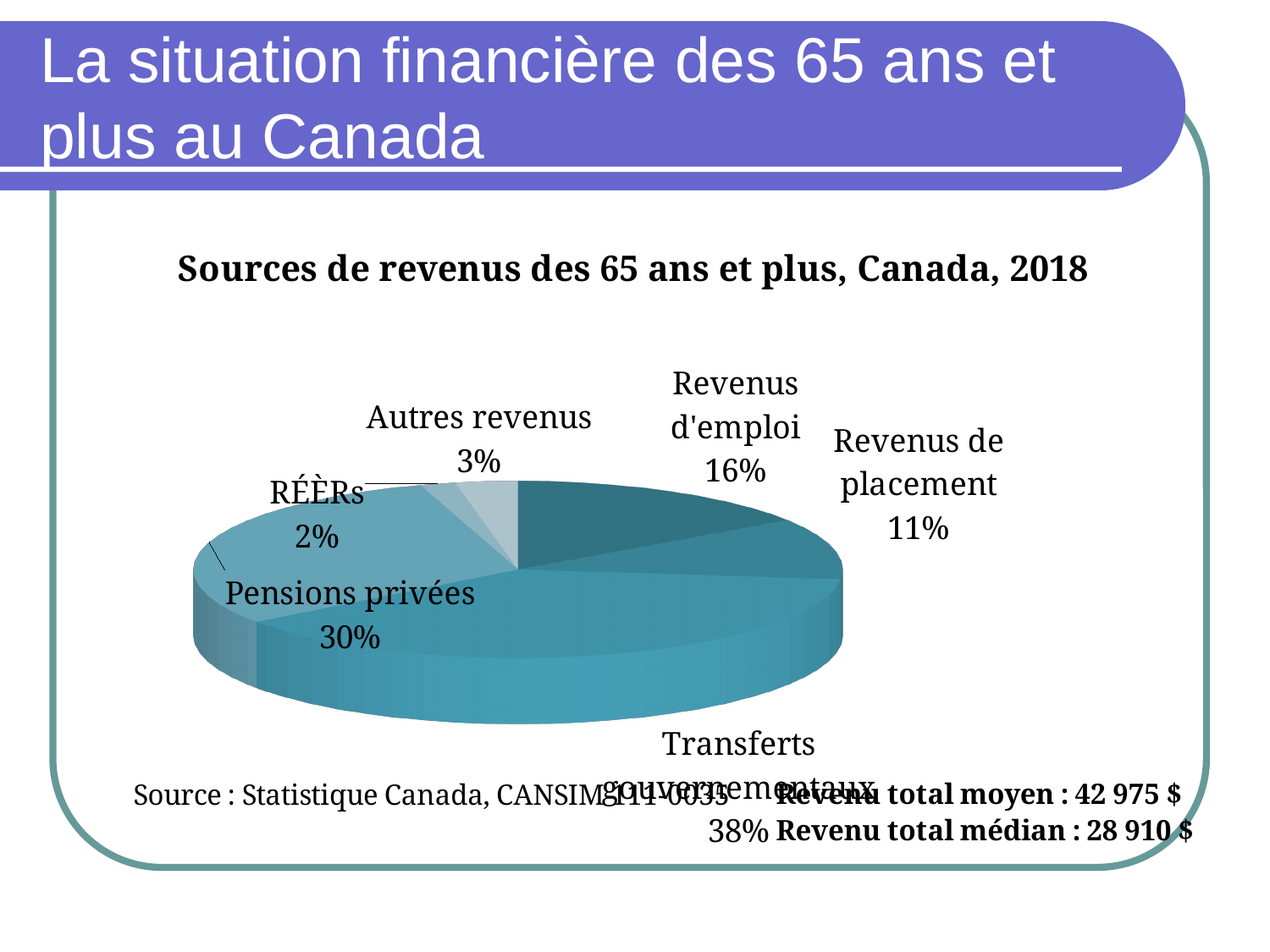
What is the value shown for Revenus d'emploi? 16% How many slices does the pie chart have? 6 Which source of income has the smallest share of the pie? RÉÈRs Which source of income has the largest share of the pie? Transferts gouvernementaux What is the difference in percentage points between Transferts gouvernementaux and Pensions privées? 8 What kind of chart is shown on the slide? Pie chart Which is larger, Revenus d'emploi or Revenus de placement? Revenus d'emploi What share of the pie is Pensions privées? 30% What share of the pie is Transferts gouvernementaux? 38% What is the title of the chart? Sources de revenus des 65 ans et plus, Canada, 2018 What is the value shown for Revenus de placement? 11% What is the value shown for RÉÈRs? 2%